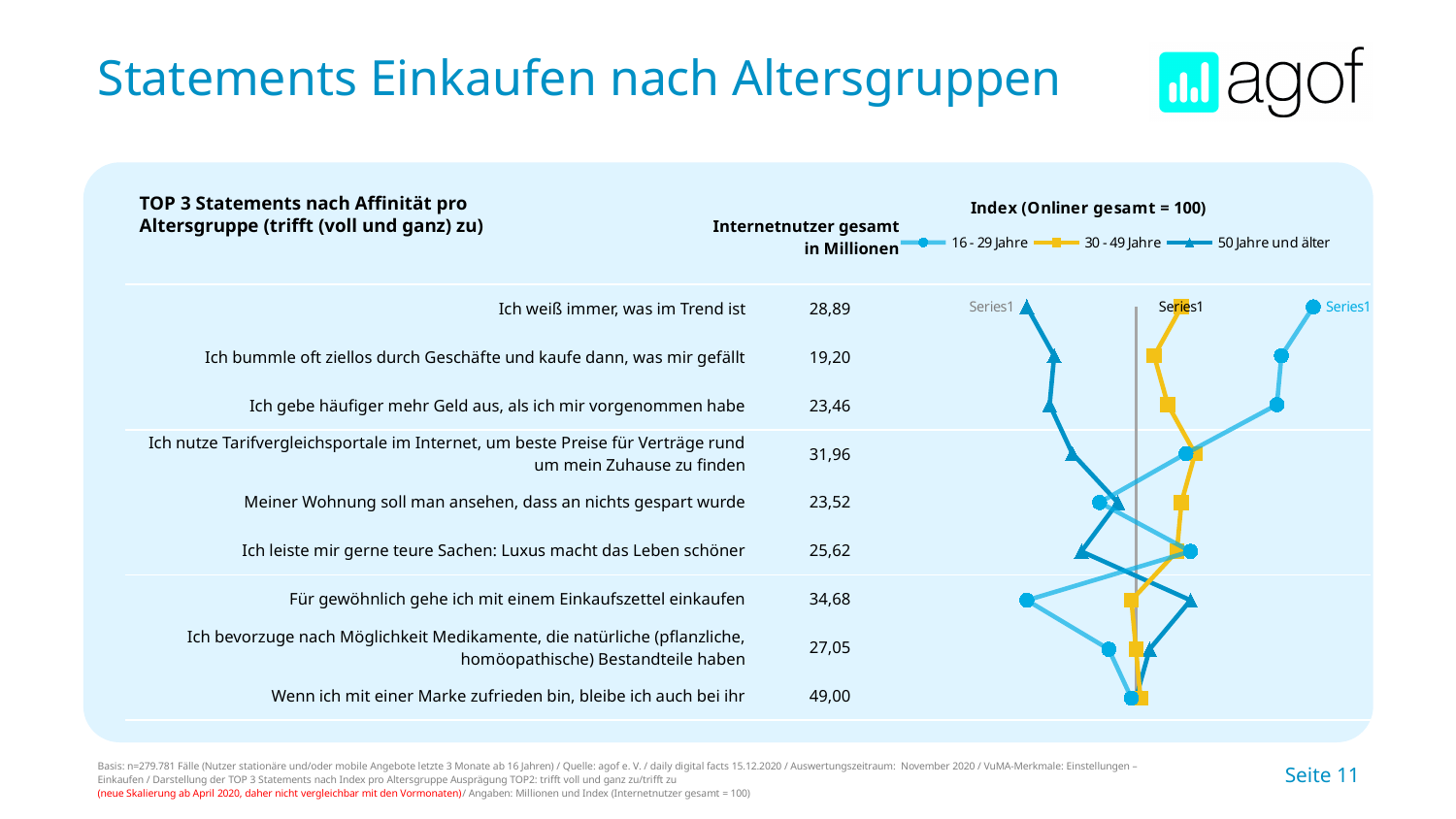
Which age groups are listed in the chart legend? 16 - 29 Jahre, 30 - 49 Jahre, 50 Jahre und älter For the statement 'Für gewöhnlich gehe ich mit einem Einkaufszettel einkaufen', is the index for 16 - 29 Jahre greater or less than 100? less How many statements (categories) are plotted in the chart? 9 How many series does the chart legend list? 3 Which age group has the highest index for the statement 'Ich weiß immer, was im Trend ist'? 16 - 29 Jahre Which age group has the lowest index for the statement 'Für gewöhnlich gehe ich mit einem Einkaufszettel einkaufen'? 16 - 29 Jahre For the statement 'Für gewöhnlich gehe ich mit einem Einkaufszettel einkaufen', is the index for 50 Jahre und älter greater or less than 100? greater What is the title of the chart? Index (Onliner gesamt = 100) For the statement 'Ich gebe häufiger mehr Geld aus, als ich mir vorgenommen habe', which index is larger: 16 - 29 Jahre or 50 Jahre und älter? 16 - 29 Jahre For the statement 'Ich weiß immer, was im Trend ist', is the index for 16 - 29 Jahre greater or less than 100? greater What kind of chart is shown on the slide? line chart